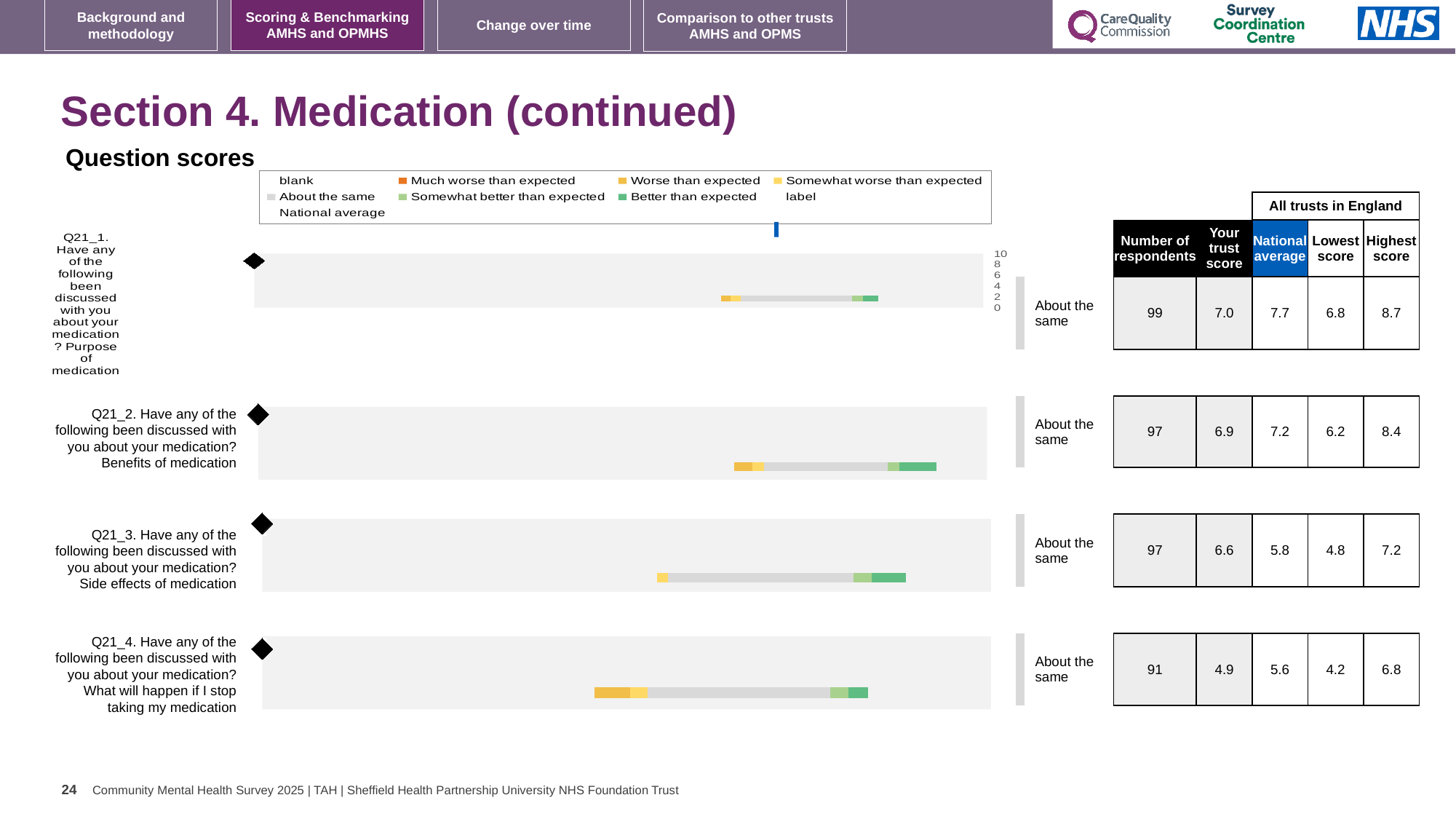
What is the national average for Q21_3 (Side effects of medication)? 5.8 What is the trust score for Q21_1 (Purpose of medication)? 7.0 What is the lowest score across all trusts in England for Q21_2 (Benefits of medication)? 6.2 How many questions are charted on this slide? 4 For Q21_3 (Side effects of medication), is the trust score higher or lower than the national average? higher What benchmark category is shown for Q21_4 (What will happen if I stop taking my medication)? About the same For Q21_1 (Purpose of medication), how much higher is the national average than the trust score? 0.7 How many respondents answered Q21_4 (What will happen if I stop taking my medication)? 91 For Q21_2 (Benefits of medication), what is the difference between the highest score and the lowest score across all trusts in England? 2.2 What kind of chart is used to show the question scores for Q21_1 to Q21_4? bar chart Which question has the highest trust score on this slide? Q21_1 (Purpose of medication) Which question has the lowest trust score on this slide? Q21_4 (What will happen if I stop taking my medication)